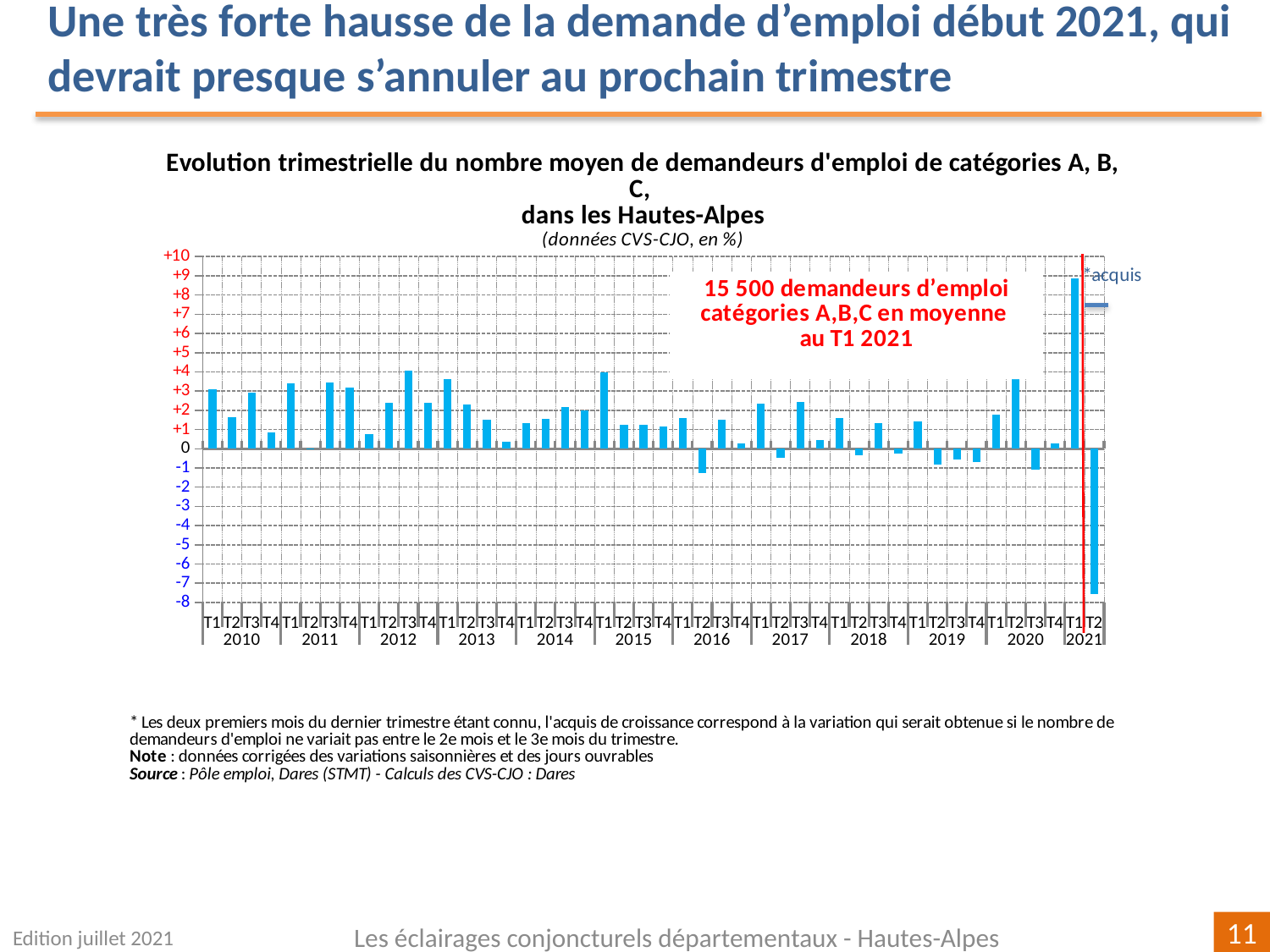
Is the value for T2 2020 greater or less than +3? greater What kind of chart is shown on the slide? Bar chart According to the chart's subtitle, in what unit are the data expressed? en % Which quarter has the lowest value in the chart? T2 2021 Which is larger, the value for T1 2010 or the value for T2 2010? T1 2010 According to the annotation on the chart, how many demandeurs d'emploi catégories A,B,C were there on average in T1 2021? 15 500 Is the value for T1 2021 greater or less than +8? greater Is the value for T4 2020 greater or less than +1? less How many quarterly bars are plotted in the chart? 46 Which quarter has the highest value in the chart? T1 2021